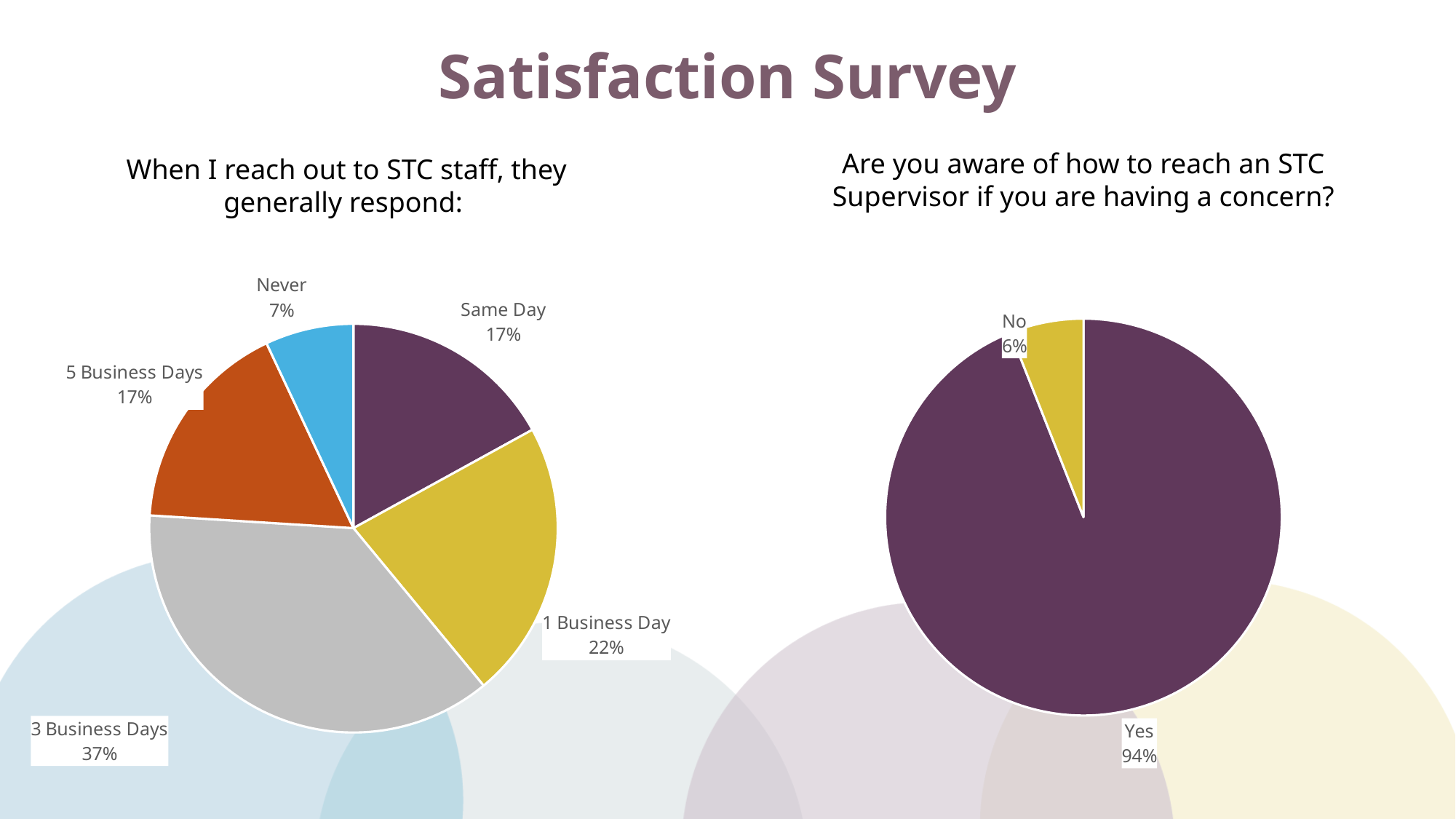
In the left chart ("When I reach out to STC staff, they generally respond:"), what percentage of responses is "1 Business Day"? 22% In the left chart ("When I reach out to STC staff, they generally respond:"), which is larger, "Same Day" or "1 Business Day"? 1 Business Day In the left chart ("When I reach out to STC staff, they generally respond:"), how many categories are shown? 5 In the left chart ("When I reach out to STC staff, they generally respond:"), what percentage of responses is "Never"? 7% In the right chart ("Are you aware of how to reach an STC Supervisor if you are having a concern?"), what percentage answered "Yes"? 94% In the left chart ("When I reach out to STC staff, they generally respond:"), which category has the smallest share? Never What is the title of the slide? Satisfaction Survey In the left chart ("When I reach out to STC staff, they generally respond:"), which category has the largest share? 3 Business Days What kind of chart is the right chart ("Are you aware of how to reach an STC Supervisor if you are having a concern?")? Pie chart In the right chart ("Are you aware of how to reach an STC Supervisor if you are having a concern?"), what percentage answered "No"? 6% In the left chart ("When I reach out to STC staff, they generally respond:"), what is the difference in percentage points between "3 Business Days" and "1 Business Day"? 15 In the left chart ("When I reach out to STC staff, they generally respond:"), what percentage of responses is "3 Business Days"? 37%